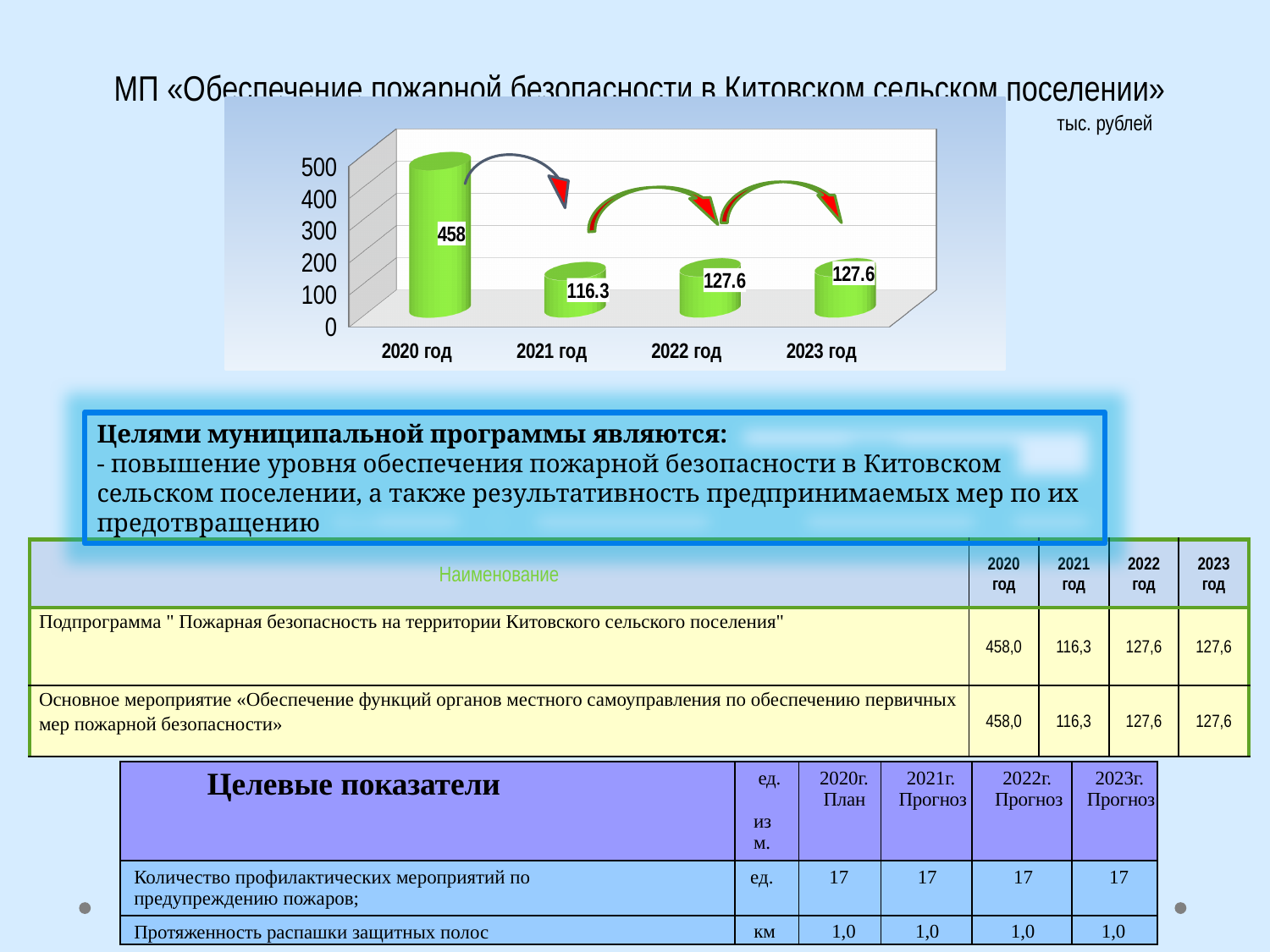
What is the difference between the values for 2020 год and 2021 год? 341.7 Which is larger, the value for 2021 год or the value for 2022 год? 2022 год Which year has the lowest value on the chart? 2021 год How many years are shown on the chart's x axis? 4 Is the value for 2020 год greater or less than 400? greater What is the difference between the values for 2022 год and 2021 год? 11.3 What is the value for 2023 год on the chart? 127.6 What unit is indicated for the chart values? тыс. рублей What is the value for 2020 год on the chart? 458 What is the value for 2022 год on the chart? 127.6 Which year has the highest value on the chart? 2020 год What is the value for 2021 год on the chart? 116.3